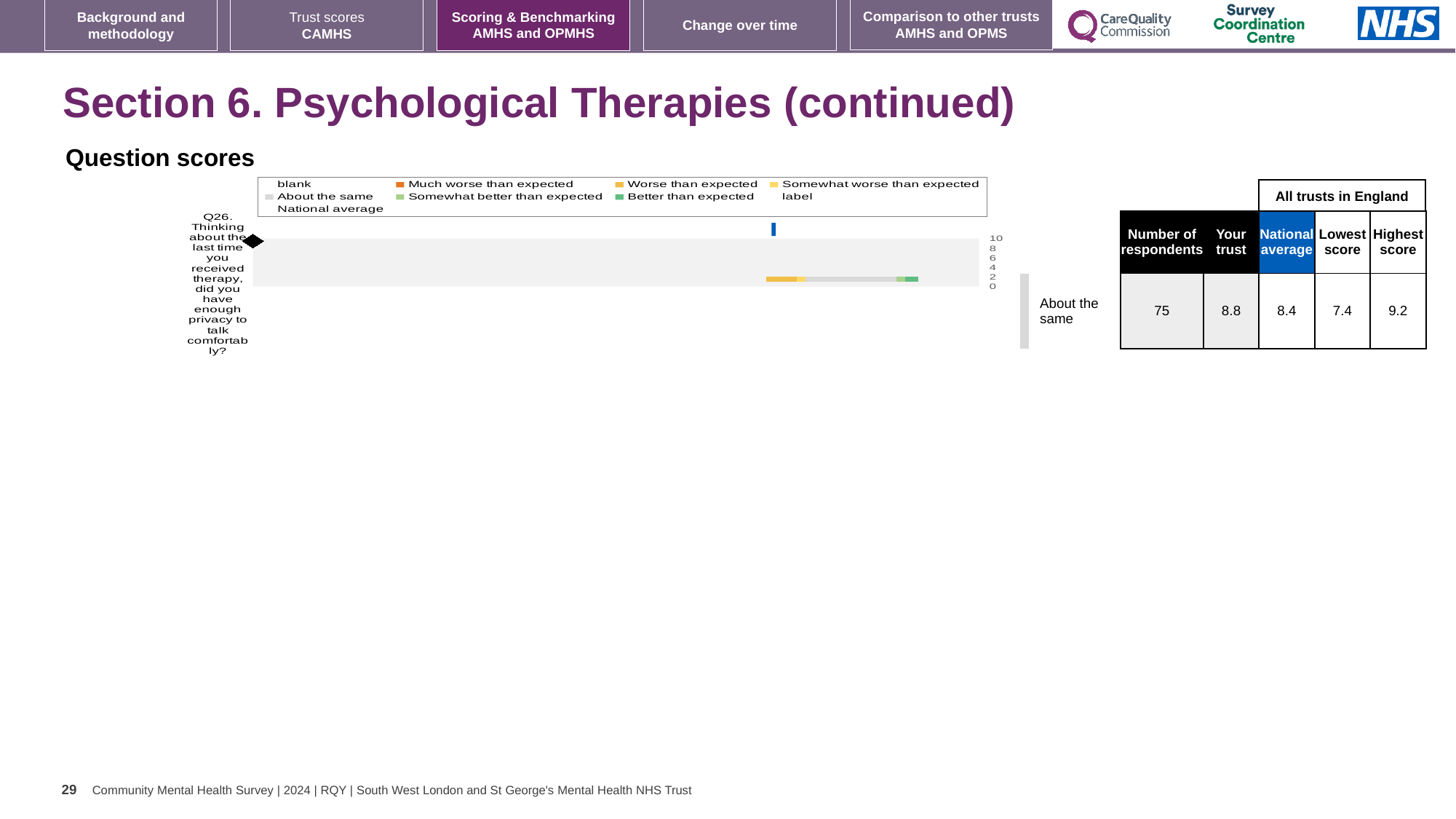
In the Question scores chart, which benchmarking category is the trust's result for Q26 placed in? About the same For Q26, what is the difference between the 'Your trust' score and the national average? 0.4 What is the 'Your trust' score for Q26 in the Question scores chart? 8.8 How many respondents answered Q26 for this trust? 75 What is the lowest score among all trusts in England for Q26? 7.4 What kind of chart is shown under 'Question scores'? bar chart How many questions are plotted in the Question scores chart? 1 What is the highest score among all trusts in England for Q26? 9.2 In the Question scores chart, what colour is the legend entry 'Better than expected'? green For Q26, which is higher: the 'Your trust' score or the national average? Your trust For Q26, what is the difference between the highest score and the lowest score among all trusts in England? 1.8 What is the national average score for Q26 in the Question scores chart? 8.4